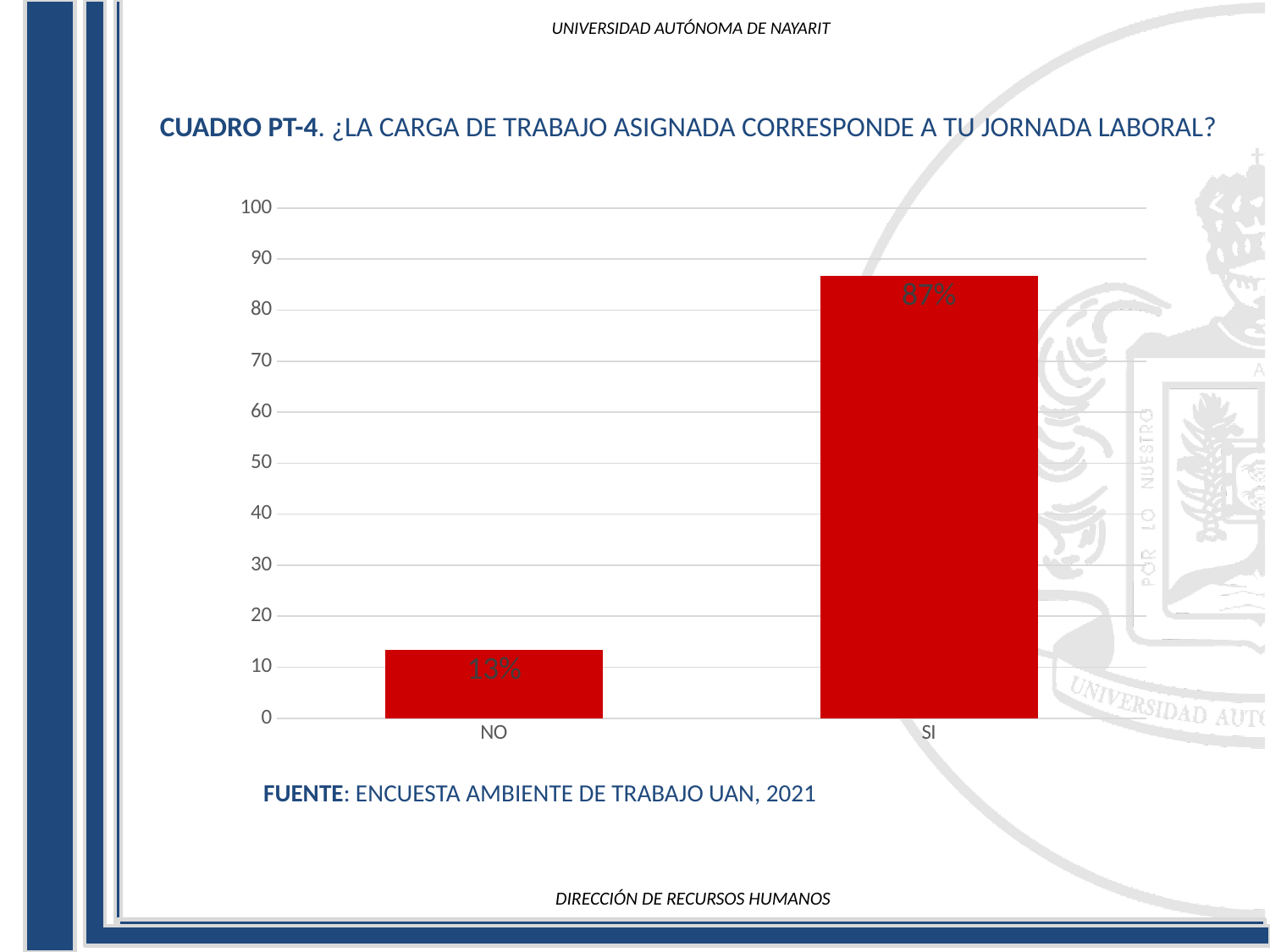
Which category has the highest value? SI What is the difference between the values for SI and NO? 74% Which category has the lowest value? NO What is the value for SI? 87% What is the value for NO? 13% Is the value for SI greater or less than 80? greater Which is larger, the value for NO or the value for SI? SI Is the value for NO greater or less than 20? less How many categories are shown on the x axis? 2 What is the title of the chart? CUADRO PT-4. ¿LA CARGA DE TRABAJO ASIGNADA CORRESPONDE A TU JORNADA LABORAL? What colour are the bars in the chart? red What kind of chart is shown on the slide? bar chart